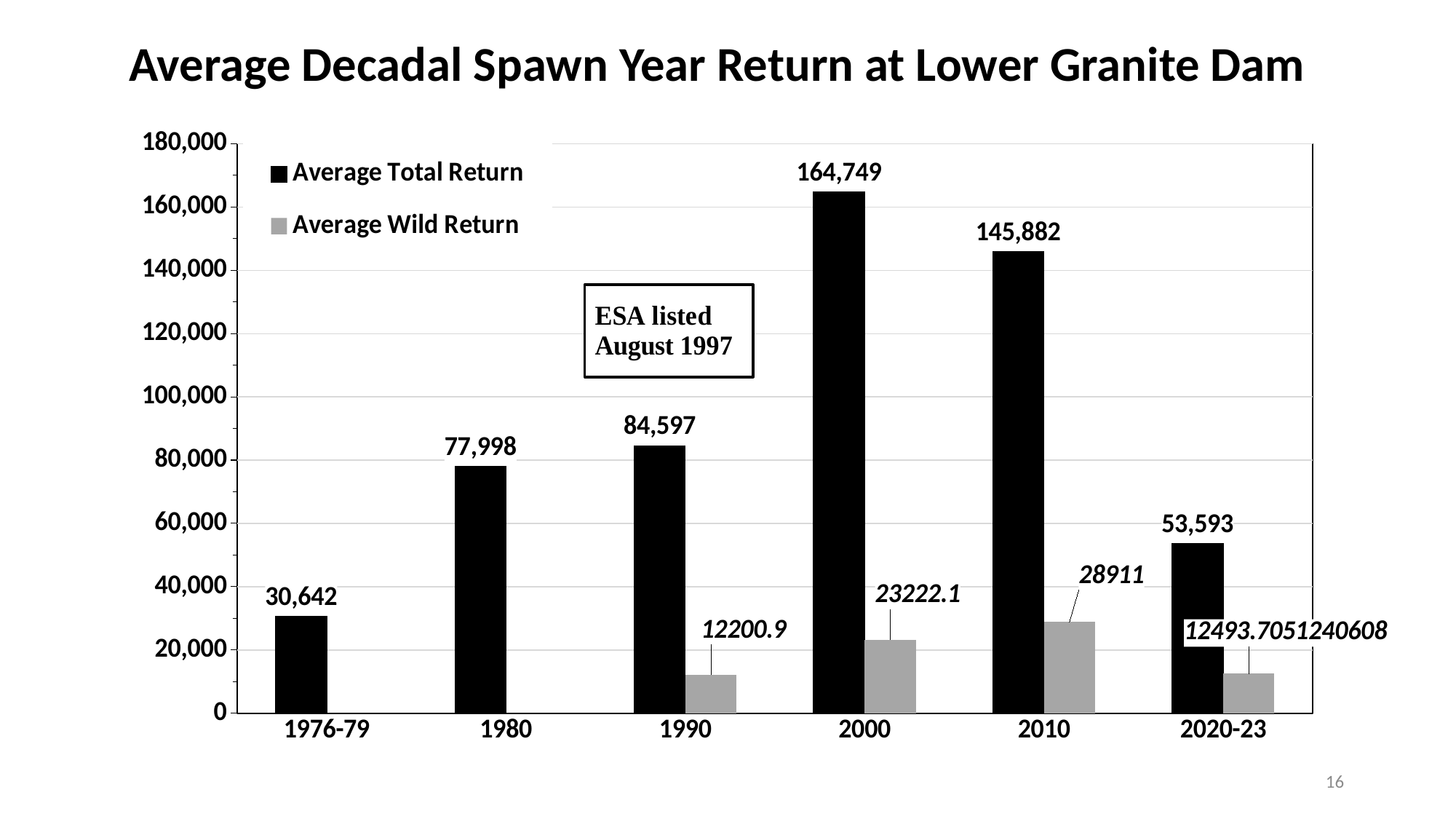
What is the Average Wild Return for 1990? 12200.9 Which category has the highest Average Total Return? 2000 What is the difference between the Average Total Return for 2000 and for 2010? 18,867 Which category has the lowest Average Total Return? 1976-79 What is the Average Wild Return for 2010? 28911 What kind of chart is shown on the slide? bar chart What is the Average Total Return for 1976-79? 30,642 How many series does the legend list? 2 Is the Average Total Return for 2020-23 greater or less than 60,000? less What is the Average Total Return for 2000? 164,749 How many categories are shown on the x axis? 6 Which is larger, the Average Total Return for 1980 or for 1990? 1990